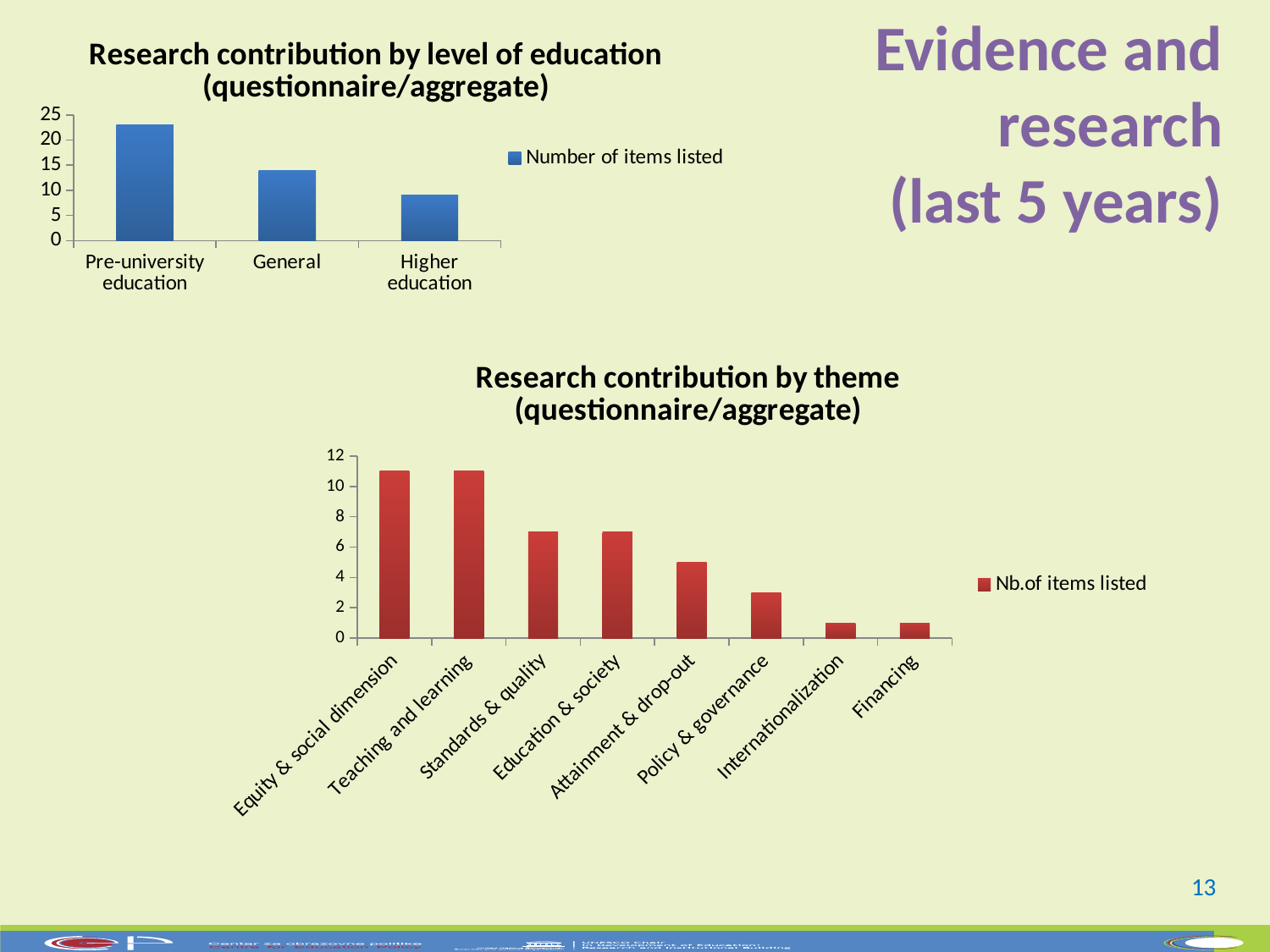
How many themes are shown in the 'Research contribution by theme' chart? 8 In the 'Research contribution by theme' chart, is the value for Policy & governance greater or less than 4? less What kind of chart is the 'Research contribution by level of education' chart? Bar chart In the 'Research contribution by level of education' chart, is the value for Higher education greater or less than 10? less In the 'Research contribution by level of education' chart, is the value for Pre-university education greater or less than 20? greater What series name does the legend of the 'Research contribution by theme' chart show? Nb.of items listed In the 'Research contribution by theme' chart, do the values generally rise or fall from left to right? Fall In the 'Research contribution by level of education' chart, which level of education has the highest number of items listed? Pre-university education How many categories are shown in the 'Research contribution by level of education' chart? 3 In the 'Research contribution by theme' chart, which is larger: Standards & quality or Policy & governance? Standards & quality In the 'Research contribution by level of education' chart, which level of education has the lowest number of items listed? Higher education